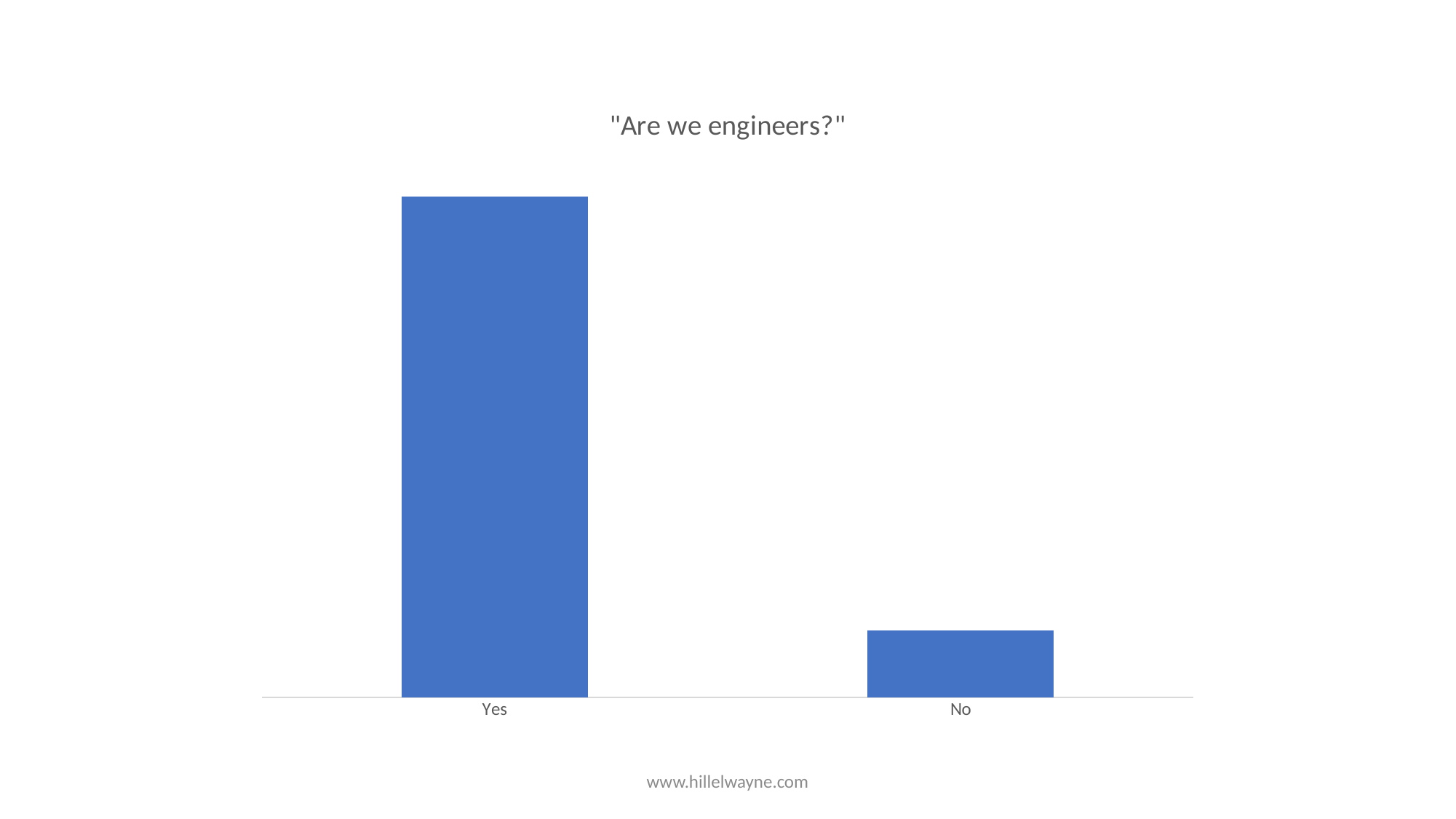
Do the bar values rise or fall from left to right along the x axis? fall Which category has the lowest bar? No What kind of chart is shown on the slide? bar chart What are the two category labels on the x axis? Yes and No Which category has the highest bar? Yes How many categories are shown on the x axis? 2 What is the title of the chart? "Are we engineers?" Which is larger, the bar for Yes or the bar for No? Yes